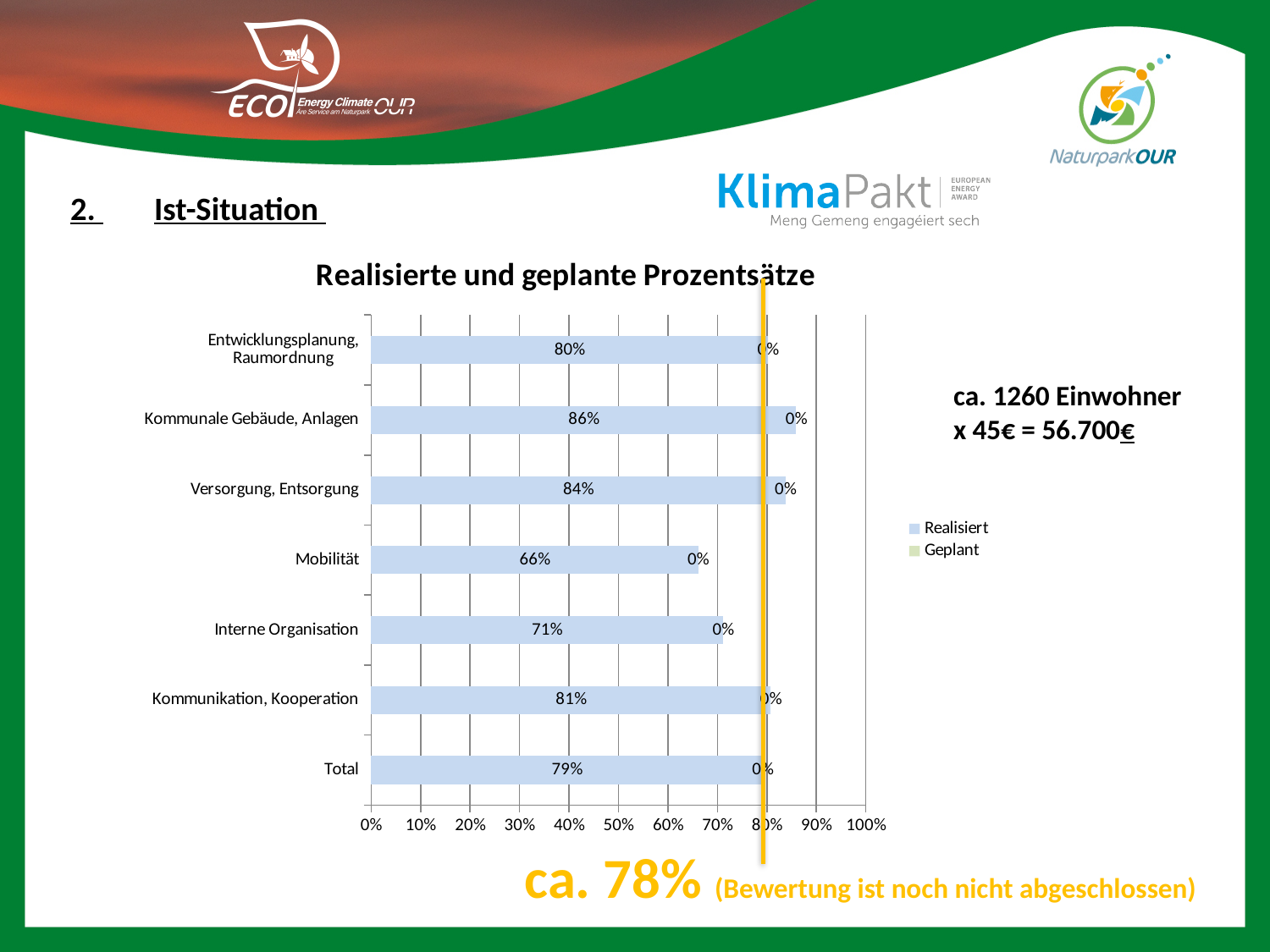
What is the difference between the Realisiert values for Versorgung, Entsorgung and Mobilität? 18% Which category has the highest Realisiert value? Kommunale Gebäude, Anlagen How many categories are shown on the chart? 7 What is the Realisiert value for Mobilität? 66% What is the Realisiert value for Kommunale Gebäude, Anlagen? 86% Which category has the lowest Realisiert value? Mobilität What is the Realisiert value for Interne Organisation? 71% What is the title of the chart? Realisierte und geplante Prozentsätze What is the Realisiert value for Total? 79% Which has a larger Realisiert value, Entwicklungsplanung, Raumordnung or Kommunikation, Kooperation? Kommunikation, Kooperation What kind of chart is shown on the slide? Bar chart How many series does the legend list? 2